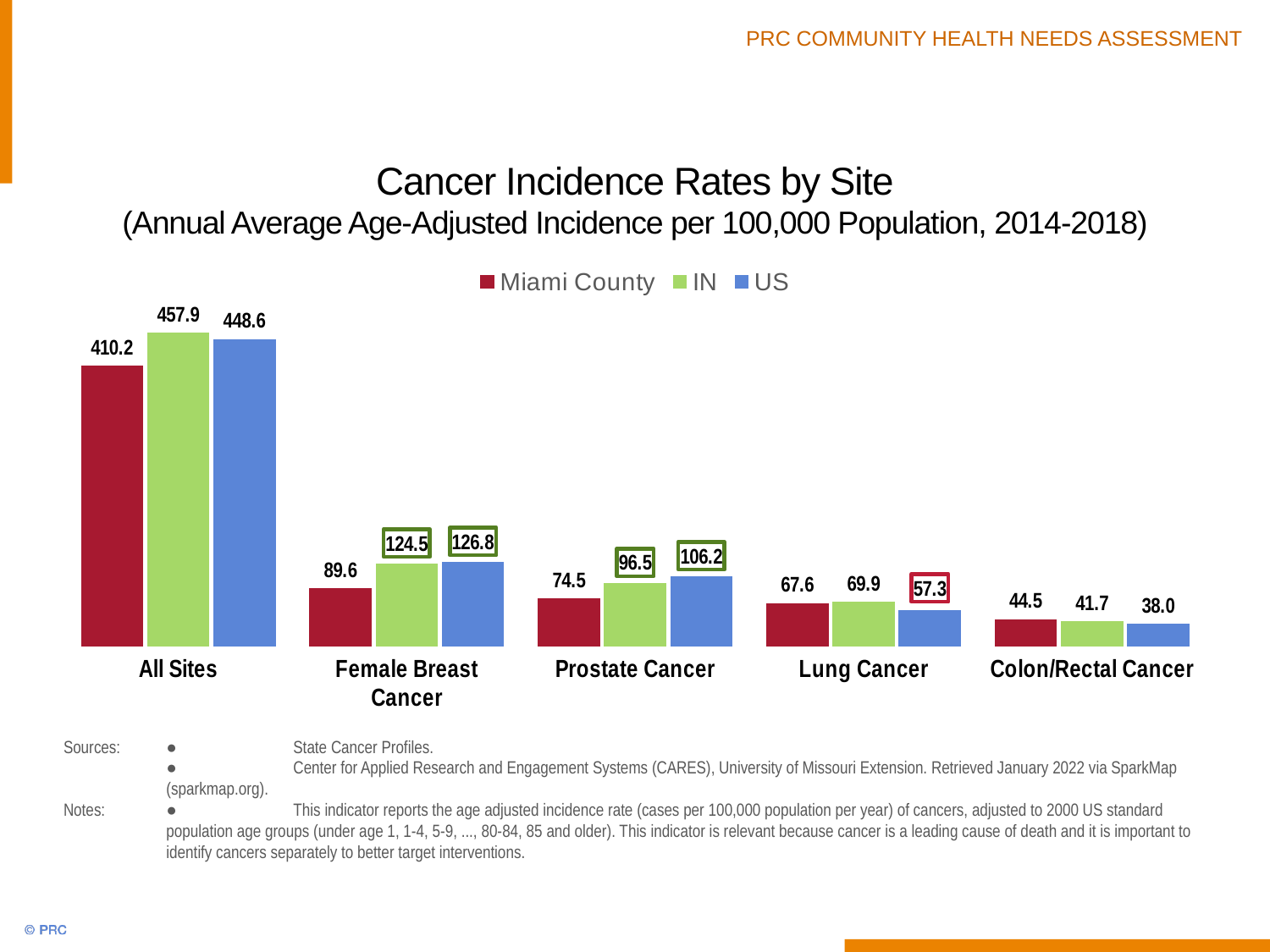
Which is larger for Lung Cancer: the Miami County rate or the US rate? Miami County What is the title of the chart? Cancer Incidence Rates by Site What is the cancer incidence rate for All Sites in Miami County? 410.2 What type of chart is shown on the slide? Bar chart Which series has the highest value for All Sites? IN What is the US incidence rate for Female Breast Cancer? 126.8 What is the IN incidence rate for Prostate Cancer? 96.5 How many cancer site categories are shown on the chart? 5 How many series does the legend list? 3 What is the Miami County incidence rate for Lung Cancer? 67.6 What is the difference between the IN and Miami County rates for Female Breast Cancer? 34.9 Which category has the lowest US incidence rate? Colon/Rectal Cancer